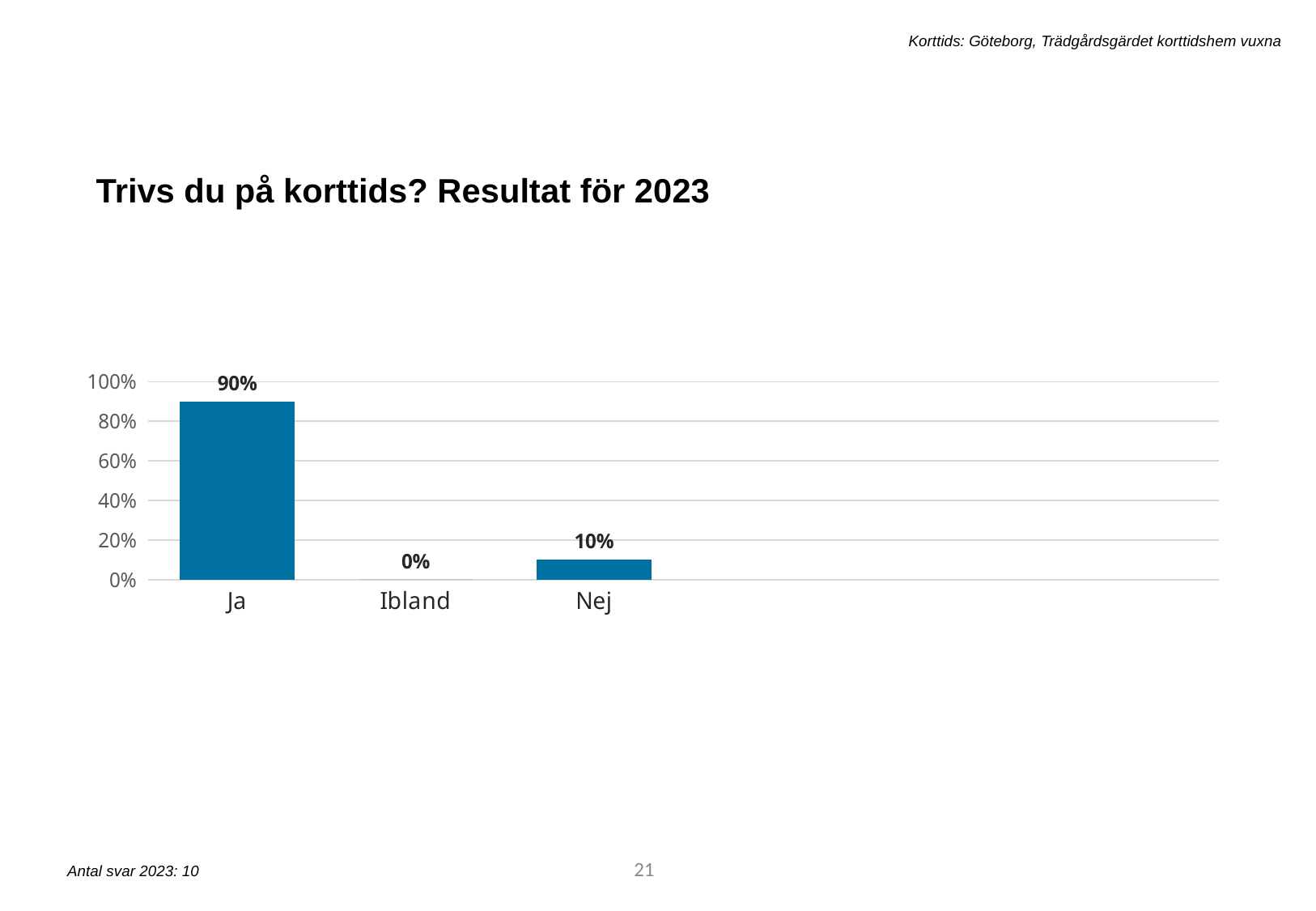
Is the value for Ja greater or less than 80%? greater Which category has the lowest value? Ibland What is the value for Ibland? 0% What kind of chart is shown on the slide? bar chart What is the highest value shown on the y axis? 100% What is the title of the slide? Trivs du på korttids? Resultat för 2023 How many categories are shown on the x axis? 3 Which category has the highest value? Ja Which is larger, the value for Nej or the value for Ibland? Nej What is the difference between the values for Ja and Nej? 80% What is the value for Ja? 90% What is the value for Nej? 10%